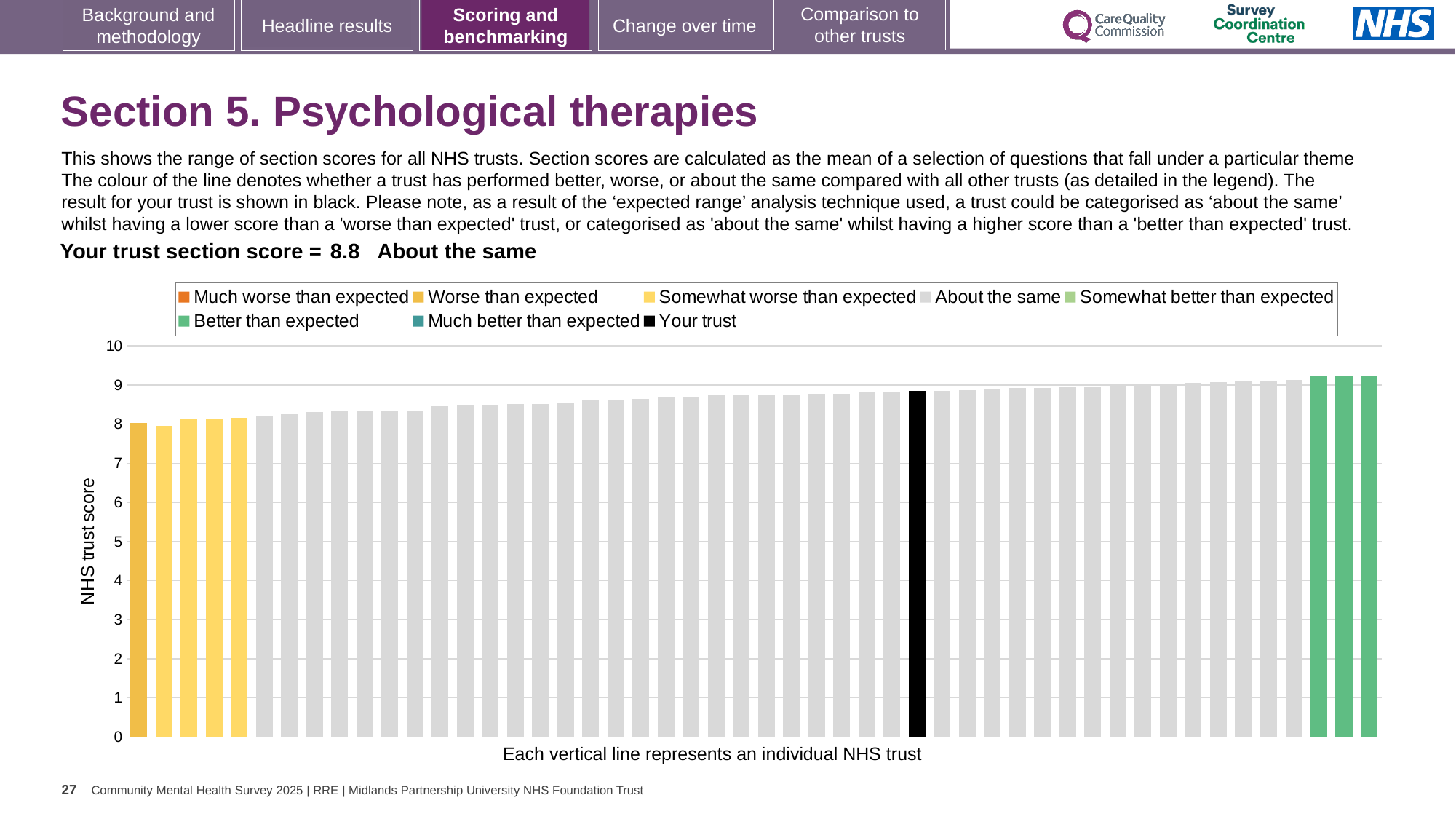
What is the label on the vertical axis of the chart? NHS trust score Which category is your trust placed in for this section? About the same What colour is used in the chart to show your trust? black How many green 'Better than expected' bars are shown in the chart? 3 What kind of chart is shown on the slide? bar chart Is the value of the lowest bar in the chart greater or less than 9? less How many entries does the chart legend list? 8 What is the section score for your trust shown on the slide? 8.8 Is the value for your trust (the black bar) greater or less than 9? less Do the bar values rise or fall from left to right along the x axis? rise Is the value of the highest bar in the chart greater or less than 9? greater